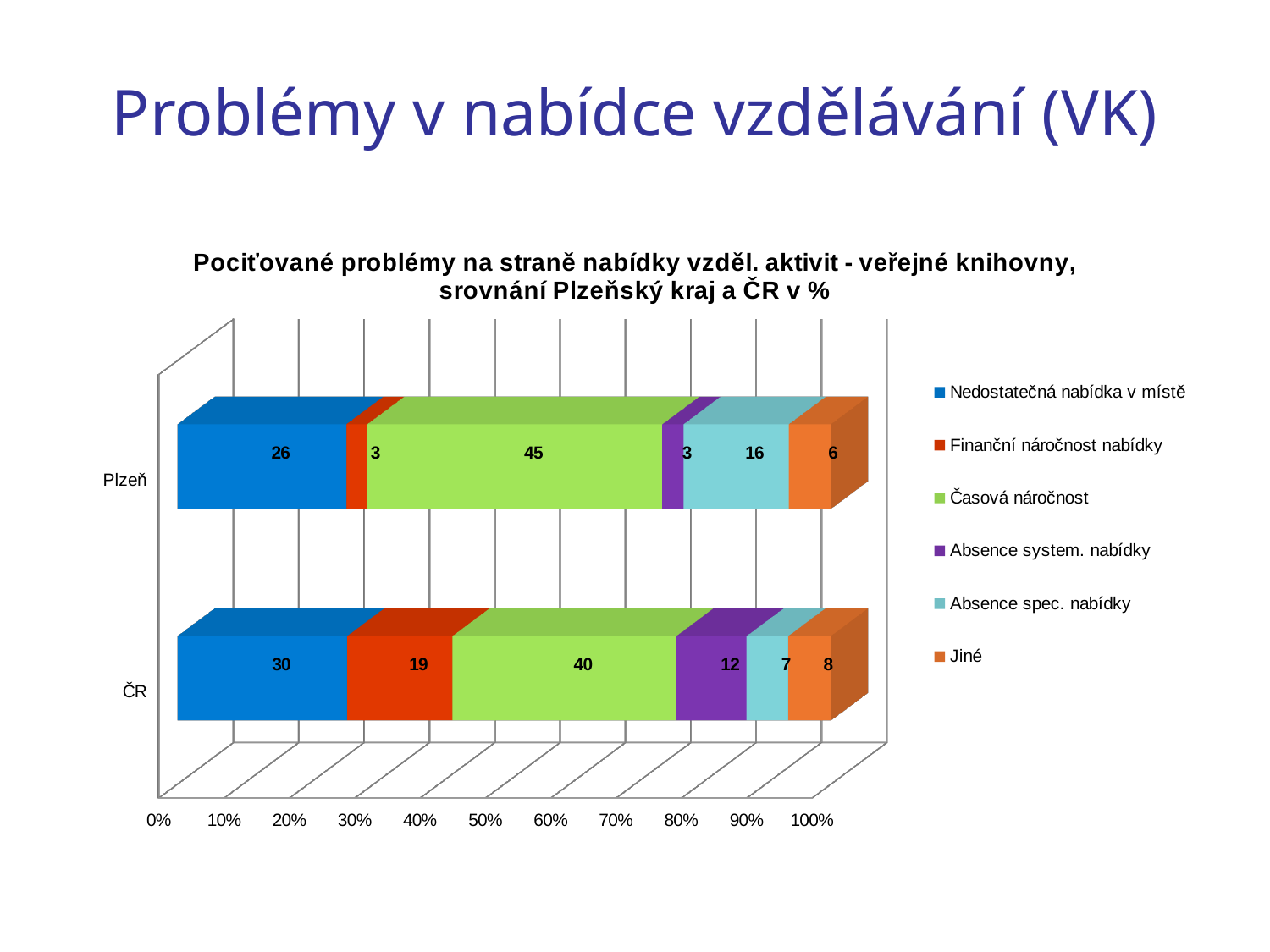
Which series has the lowest value for ČR? Absence spec. nabídky What is the value for Časová náročnost for Plzeň? 45 Which series has the highest value for Plzeň? Časová náročnost What is the value for Jiné for ČR? 8 What kind of chart is shown on the slide? Stacked bar chart What is the difference between the Finanční náročnost nabídky values for ČR and Plzeň? 16 How many series does the legend list? 6 Which is larger, the Nedostatečná nabídka v místě value for Plzeň or for ČR? ČR How many categories are shown on the vertical axis? 2 What is the value for Absence system. nabídky for ČR? 12 What is the value for Absence spec. nabídky for Plzeň? 16 What is the value for Finanční náročnost nabídky for ČR? 19